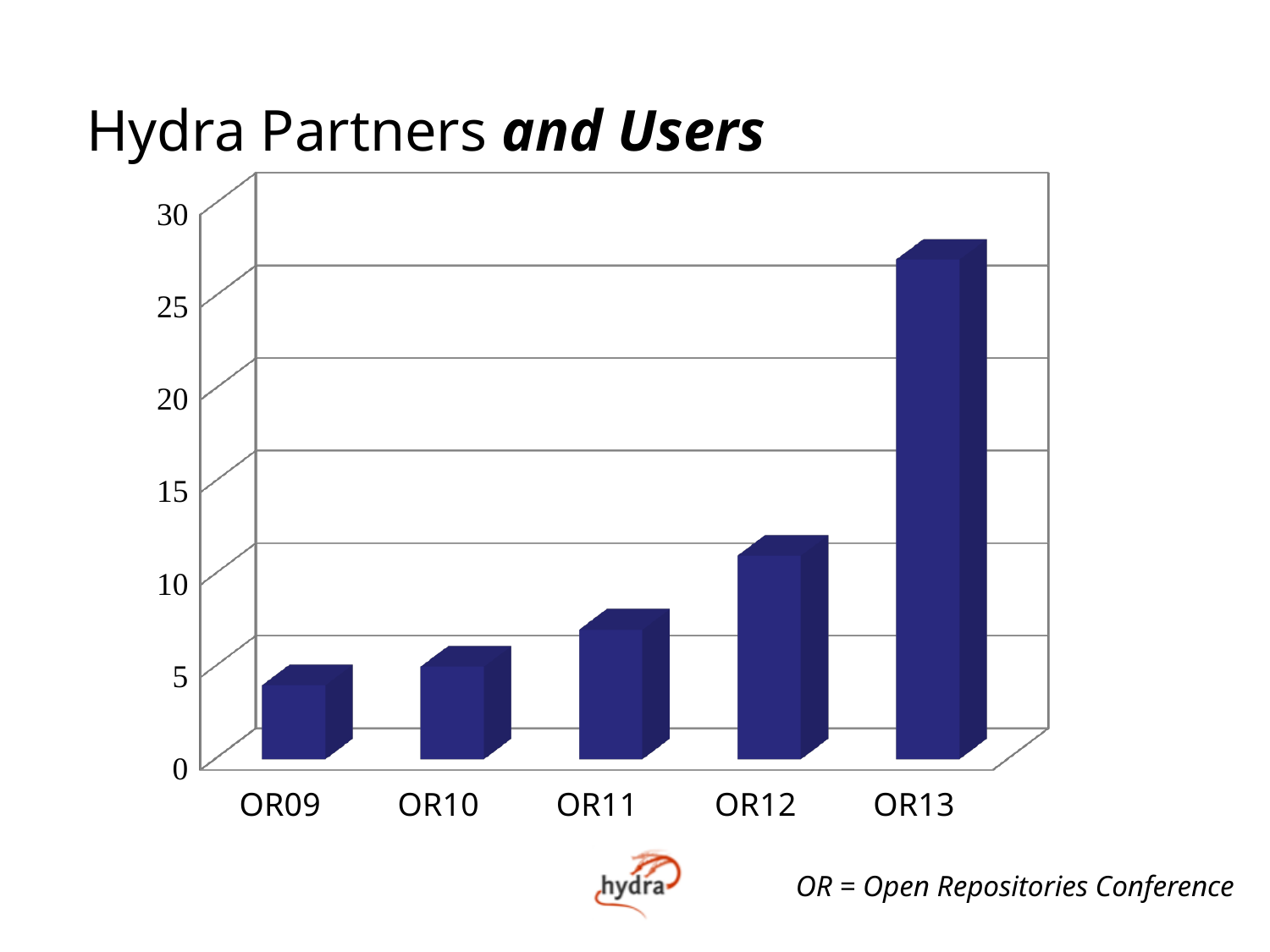
What is the title of the slide containing the chart? Hydra Partners and Users Is the value for OR13 greater or less than 25? greater Which category has the lowest bar in the chart? OR09 Is the value for OR13 greater or less than 30? less How many categories are shown on the x axis of the chart? 5 Which category has the highest bar in the chart? OR13 Do the values rise or fall from OR09 to OR13? rise Is the value for OR12 greater or less than 15? less Which is larger, the value for OR12 or the value for OR11? OR12 What kind of chart is shown on the slide? bar chart